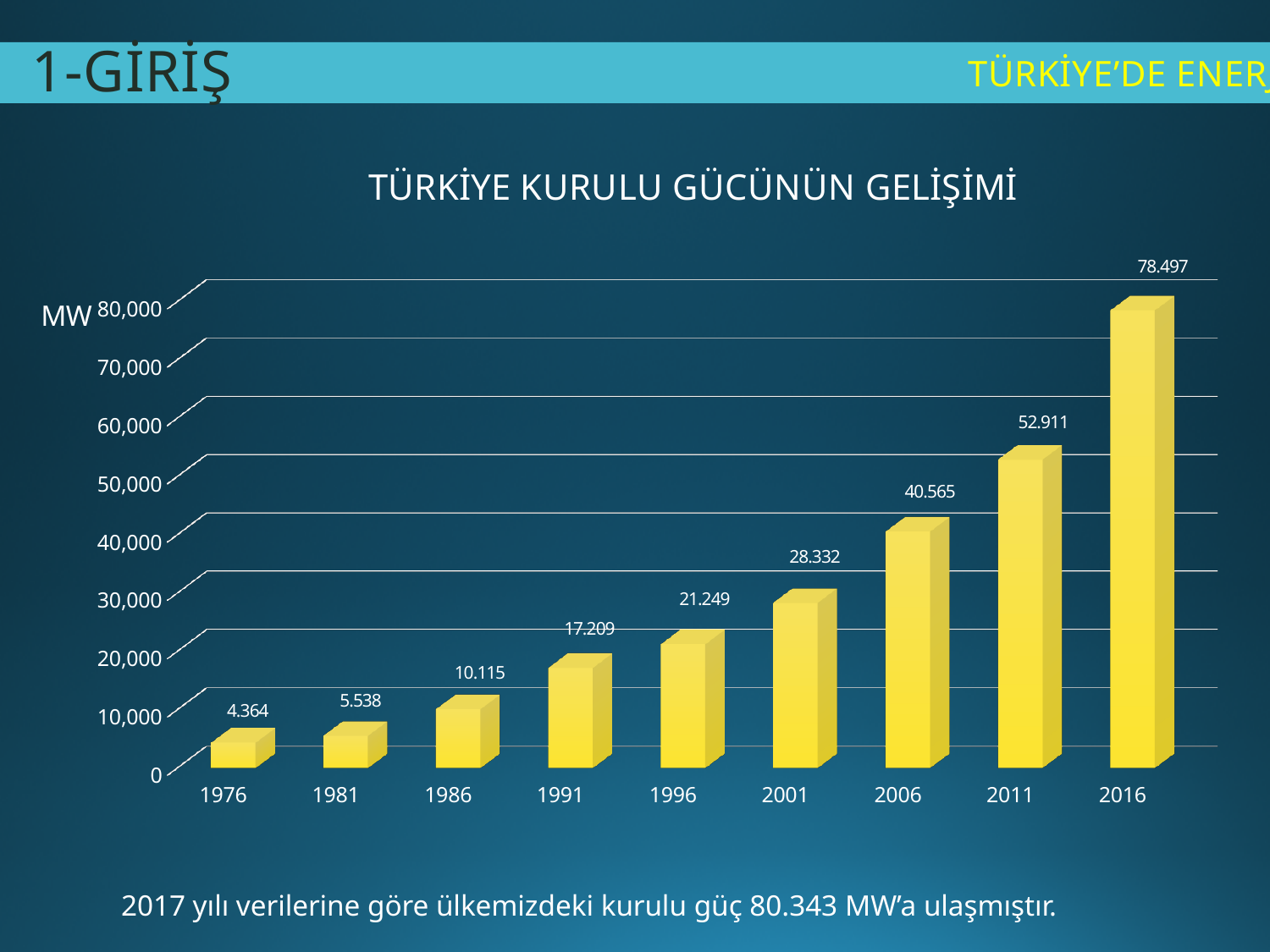
What is the value for 1991 in the chart? 17.209 What is the difference between the values for 2006 and 2001? 12.233 What is the value for 2016 in the chart? 78.497 What is the value for 2006 in the chart? 40.565 What kind of chart is shown on the slide? bar chart What is the difference between the values for 2016 and 2011? 25.586 Is the value for 2011 greater or less than 50,000? greater Which year has the lowest value in the chart? 1976 Which year has the highest value in the chart? 2016 How many years are shown on the x axis of the chart? 9 Which is larger, the value for 1996 or the value for 2001? 2001 Do the values rise or fall from 1976 to 2016? rise